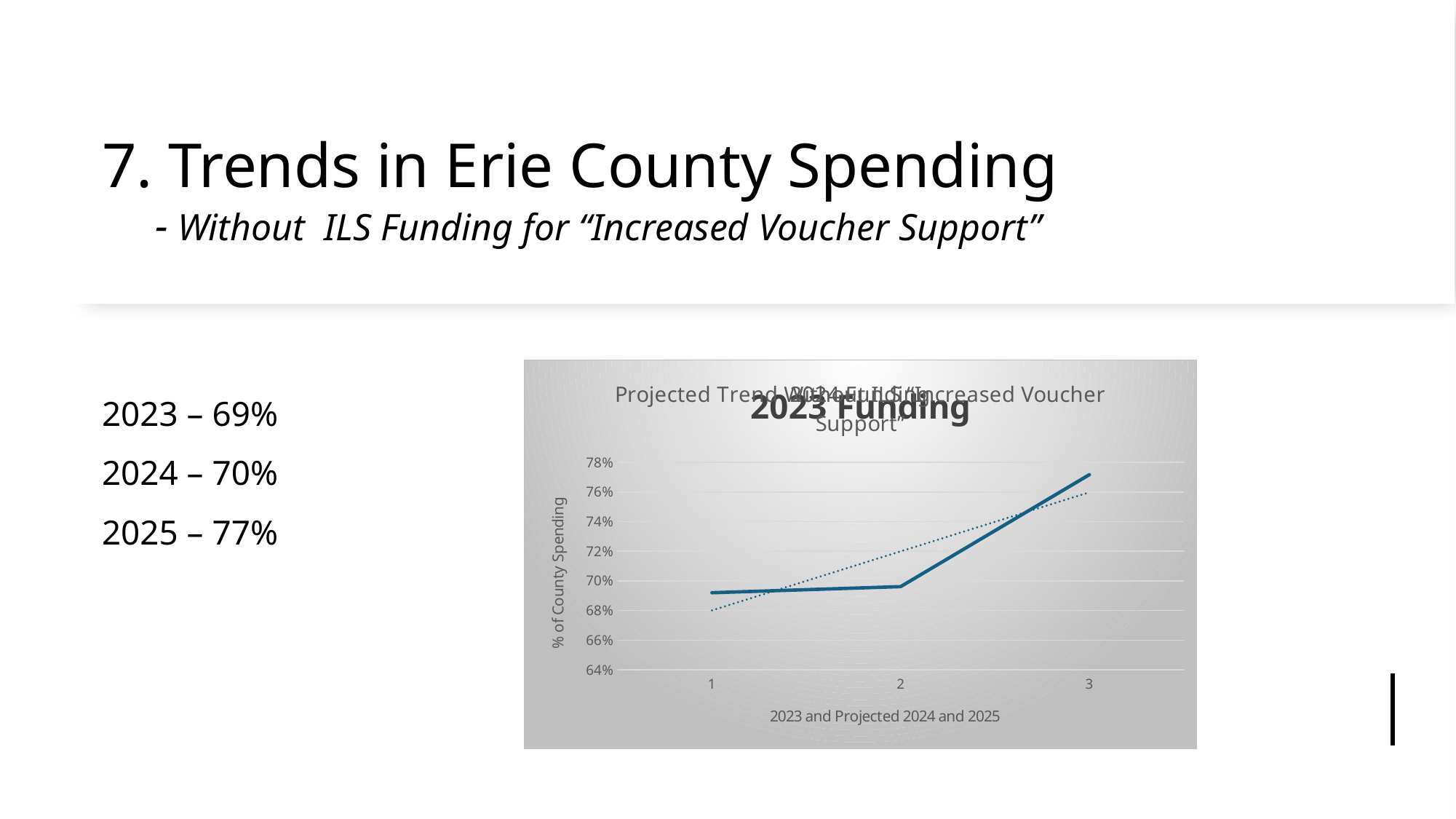
How many points are plotted along the x axis of the chart? 3 Is the value at x = 1 greater or less than 70%? less Is the value at x = 3 greater or less than 78%? less Which x-axis point has the lowest value on the solid line? 1 Is the value at x = 3 larger or smaller than the value at x = 1? larger Is the value at x = 2 greater or less than 72%? less Do the values on the solid line rise or fall from x = 1 to x = 3? rise Which x-axis point has the highest value on the solid line? 3 What kind of chart is shown on the slide? line chart What is the title of the chart's vertical axis? % of County Spending